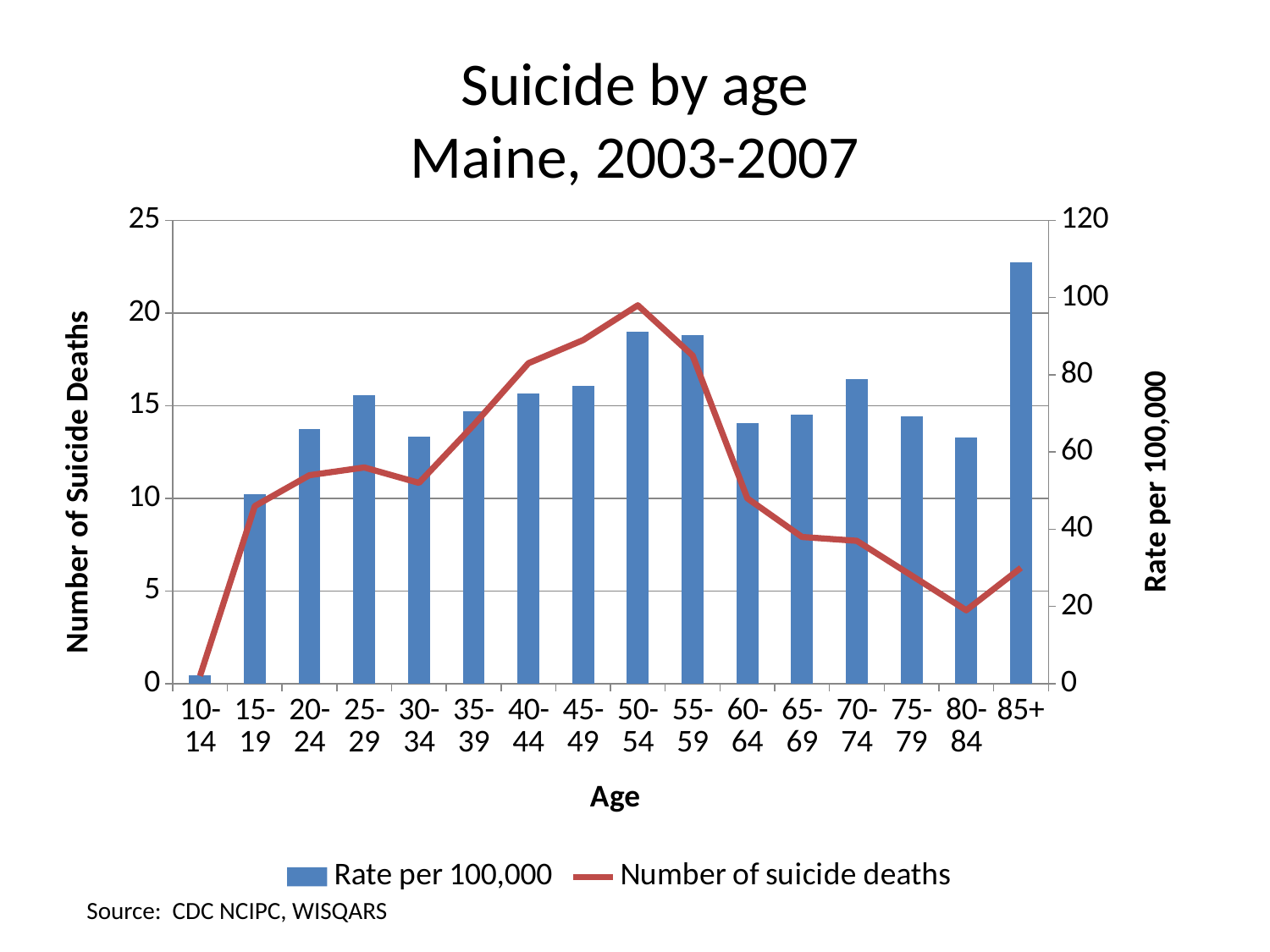
Is the 'Number of suicide deaths' line value for 50-54 greater or less than 80 on the right axis? greater Is the bar for 85+ greater or less than 20 on the left axis? greater Which age group has the tallest bar? 85+ Does the 'Number of suicide deaths' line rise or fall from 50-54 to 80-84? fall Which age group has the shortest bar? 10-14 How many age categories are shown on the x axis? 16 What is the title of the chart? Suicide by age Maine, 2003-2007 At which age group does the 'Number of suicide deaths' line reach its peak? 50-54 Is the bar for 10-14 greater or less than 5 on the left axis? less Which bar is taller, 50-54 or 30-34? 50-54 How many series does the legend list? 2 What type of chart is shown on the slide? A bar chart combined with a line